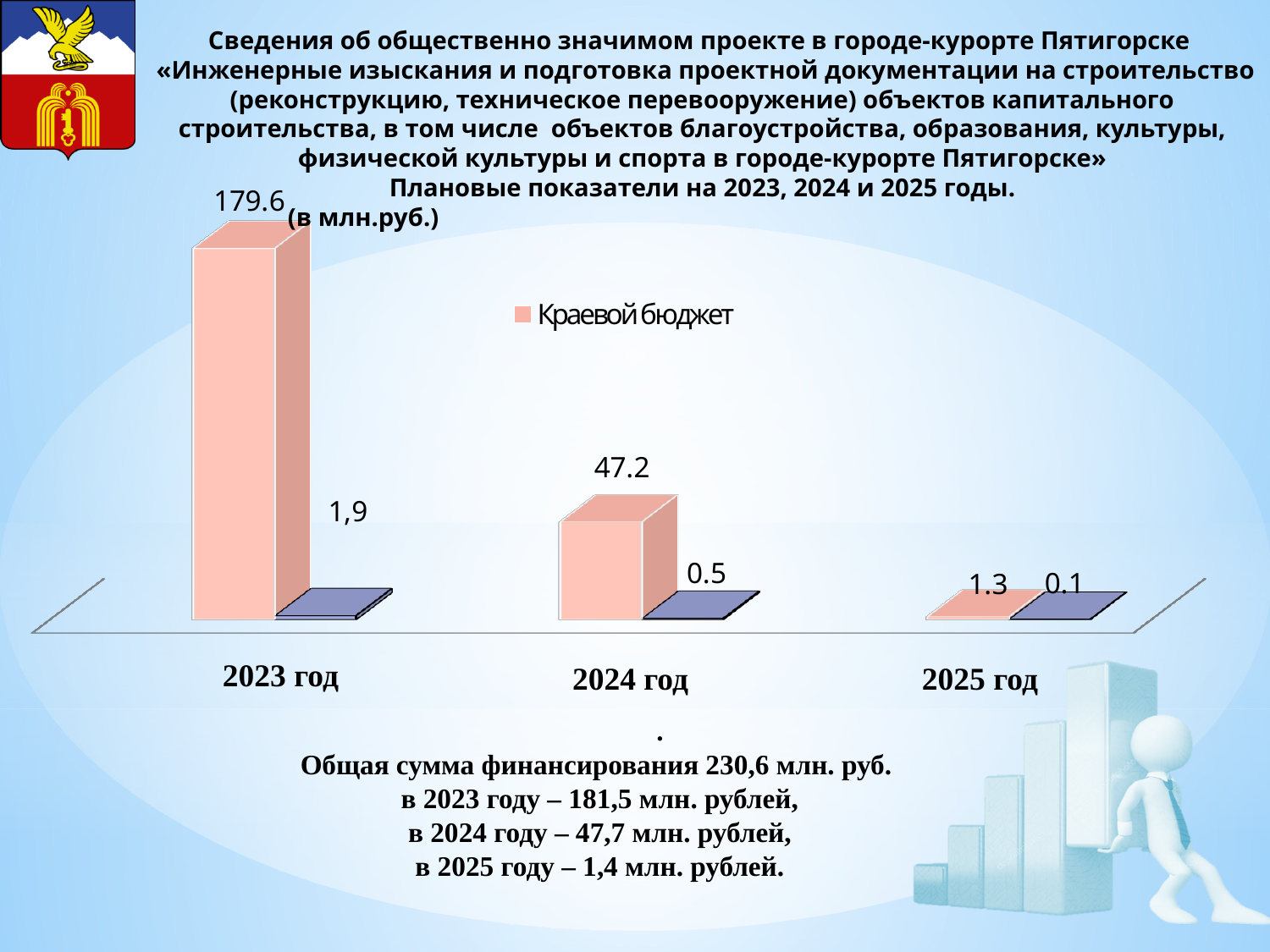
Which year has the larger Краевой бюджет value, 2024 год or 2025 год? 2024 год What value is labelled on the small blue bar for 2024 год? 0.5 What is the value of Краевой бюджет for 2025 год? 1.3 What is the value of Краевой бюджет for 2023 год? 179.6 What kind of chart is shown on the slide? bar chart In which year is the Краевой бюджет value the lowest? 2025 год How many years are shown on the x axis of the chart? 3 What value is labelled on the small blue bar for 2023 год? 1,9 In which year is the Краевой бюджет value the highest? 2023 год What is the value of Краевой бюджет for 2024 год? 47.2 What is the difference between the Краевой бюджет values for 2023 год and 2024 год? 132.4 Do the Краевой бюджет values rise or fall from 2023 год to 2025 год? fall